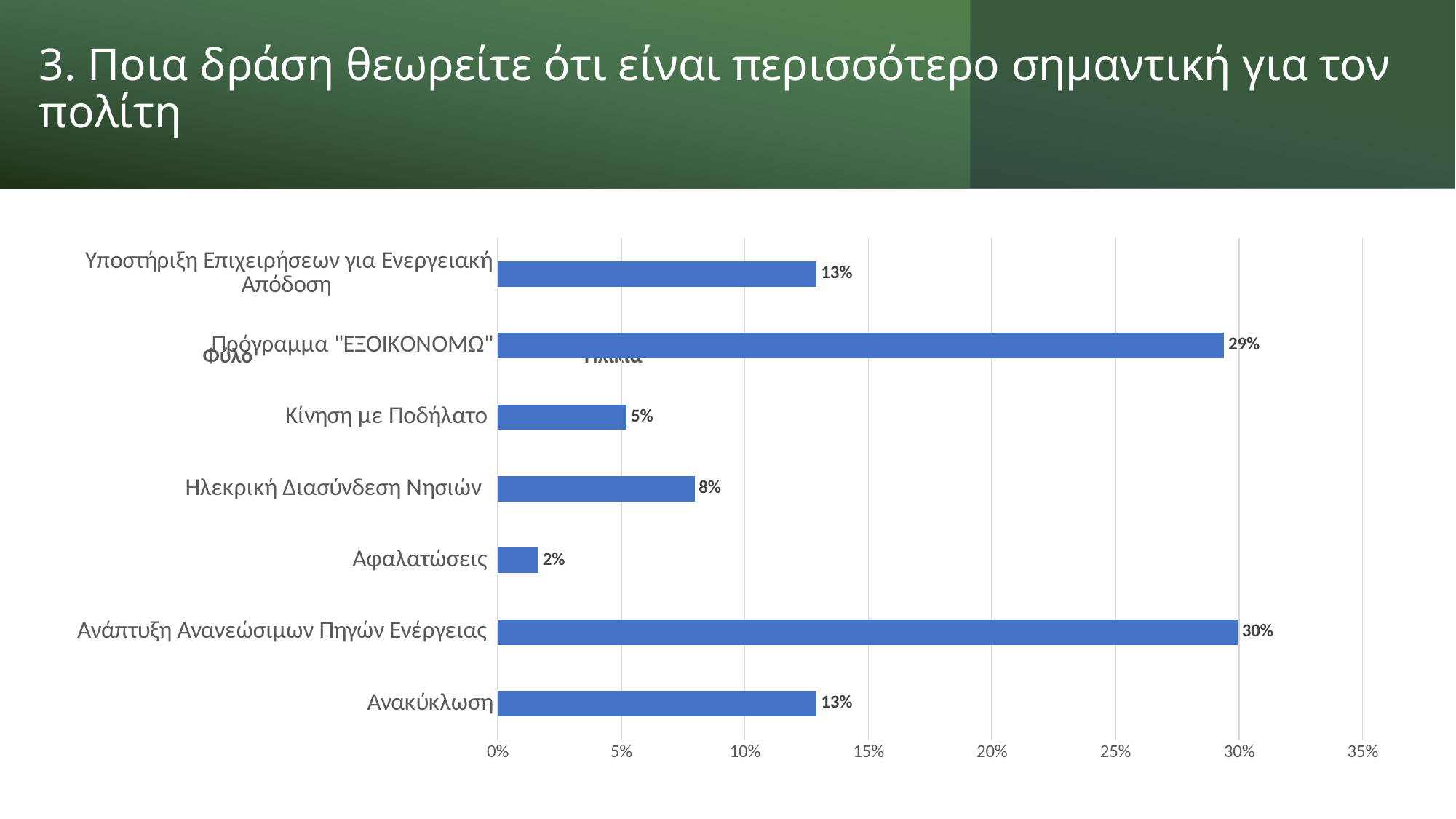
What is the difference between the values for Ανάπτυξη Ανανεώσιμων Πηγών Ενέργειας and Πρόγραμμα "ΕΞΟΙΚΟΝΟΜΩ"? 1% What kind of chart is shown on the slide? bar chart Which category has the lowest value? Αφαλατώσεις How many categories (actions) are plotted in the chart? 7 What is the value for Ανάπτυξη Ανανεώσιμων Πηγών Ενέργειας? 30% What is the value for Ηλεκρική Διασύνδεση Νησιών? 8% What is the value for Αφαλατώσεις? 2% Which category has the highest value? Ανάπτυξη Ανανεώσιμων Πηγών Ενέργειας Which is larger, the value for Κίνηση με Ποδήλατο or the value for Ηλεκρική Διασύνδεση Νησιών? Ηλεκρική Διασύνδεση Νησιών What is the difference between the values for Ανακύκλωση and Κίνηση με Ποδήλατο? 8% What is the value for Πρόγραμμα "ΕΞΟΙΚΟΝΟΜΩ"? 29% Is the value for Ανακύκλωση greater or less than 10%? greater